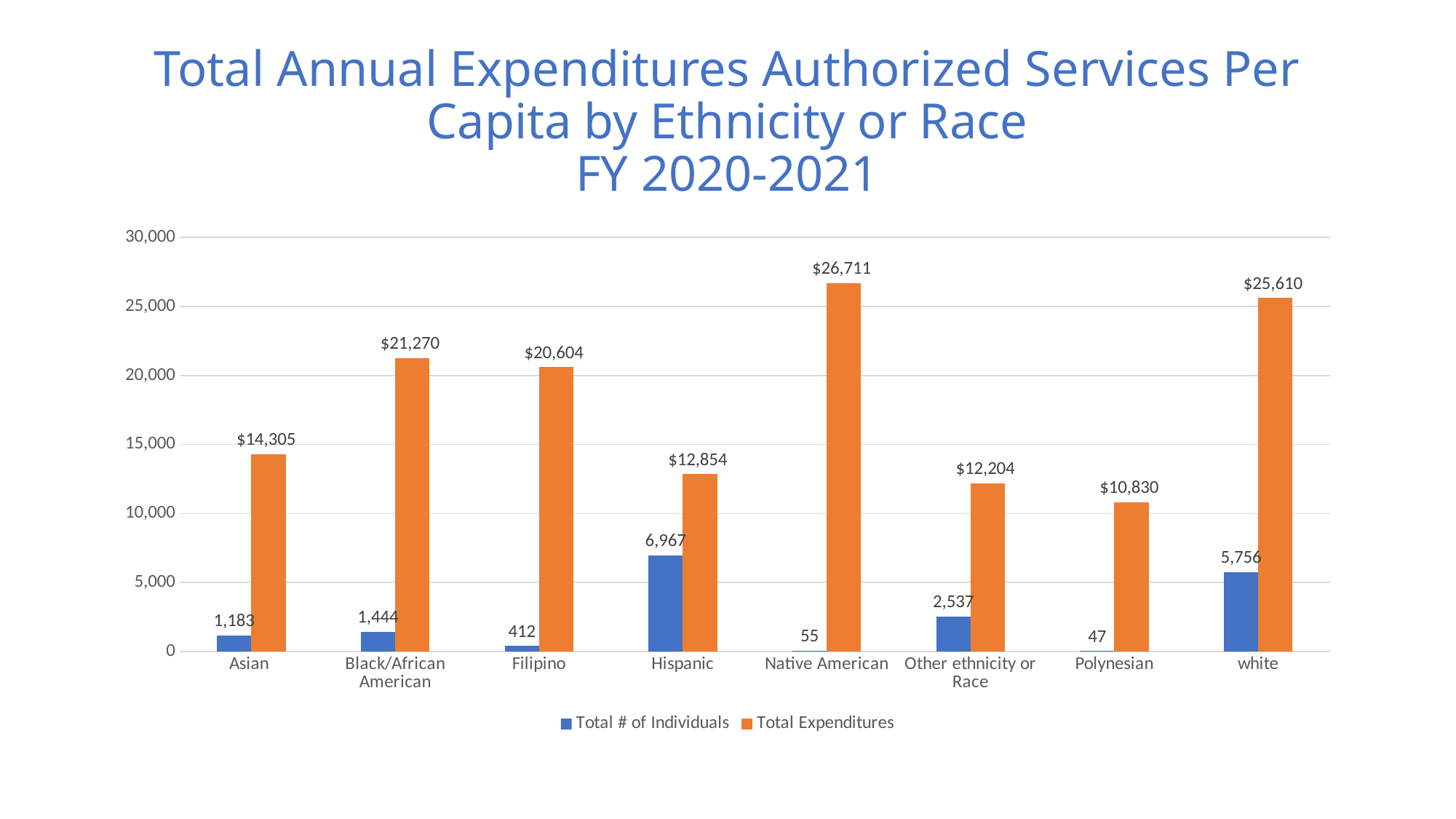
How many ethnicity or race categories are shown on the x axis? 8 Which category has the lowest Total # of Individuals? Polynesian How many series does the legend list? 2 What kind of chart is shown on the slide? bar chart Which has a larger Total # of Individuals, Hispanic or white? Hispanic Which colour represents Total Expenditures in the chart? orange What is the difference in Total Expenditures between Black/African American and Filipino? $666 What is the Total Expenditures value for Polynesian? $10,830 Which category has the highest Total Expenditures? Native American Is the Total Expenditures value for Asian greater or less than 15,000? less What is the Total # of Individuals for Hispanic? 6,967 What is the Total Expenditures value for Native American? $26,711